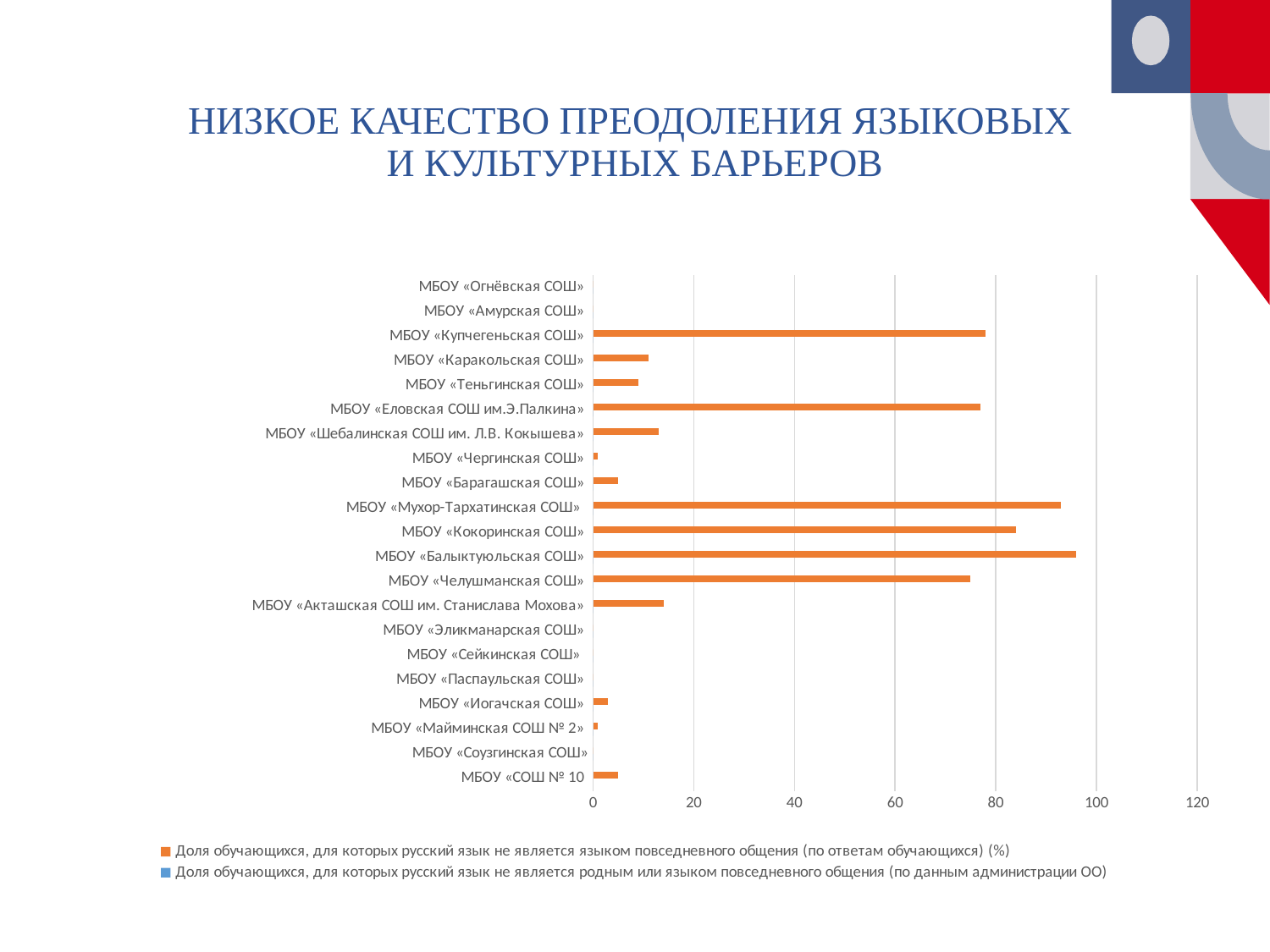
How many schools (categories) are listed on the vertical axis of the chart? 21 Is the value for МБОУ «Акташская СОШ им. Станислава Мохова» greater or less than 20? less Is the value for МБОУ «Челушманская СОШ» greater or less than 80? less Which has the larger value, МБОУ «Еловская СОШ им.Э.Палкина» or МБОУ «Теньгинская СОШ»? МБОУ «Еловская СОШ им.Э.Палкина» Which has the larger value, МБОУ «Купчегеньская СОШ» or МБОУ «Каракольская СОШ»? МБОУ «Купчегеньская СОШ» Is the value for МБОУ «Мухор-Тархатинская СОШ» greater or less than 80? greater What kind of chart is shown on the slide? bar chart What is the highest value shown on the horizontal axis of the chart? 120 What colour are the bars for the series «Доля обучающихся, для которых русский язык не является языком повседневного общения (по ответам обучающихся) (%)»? orange How many series does the legend list? 2